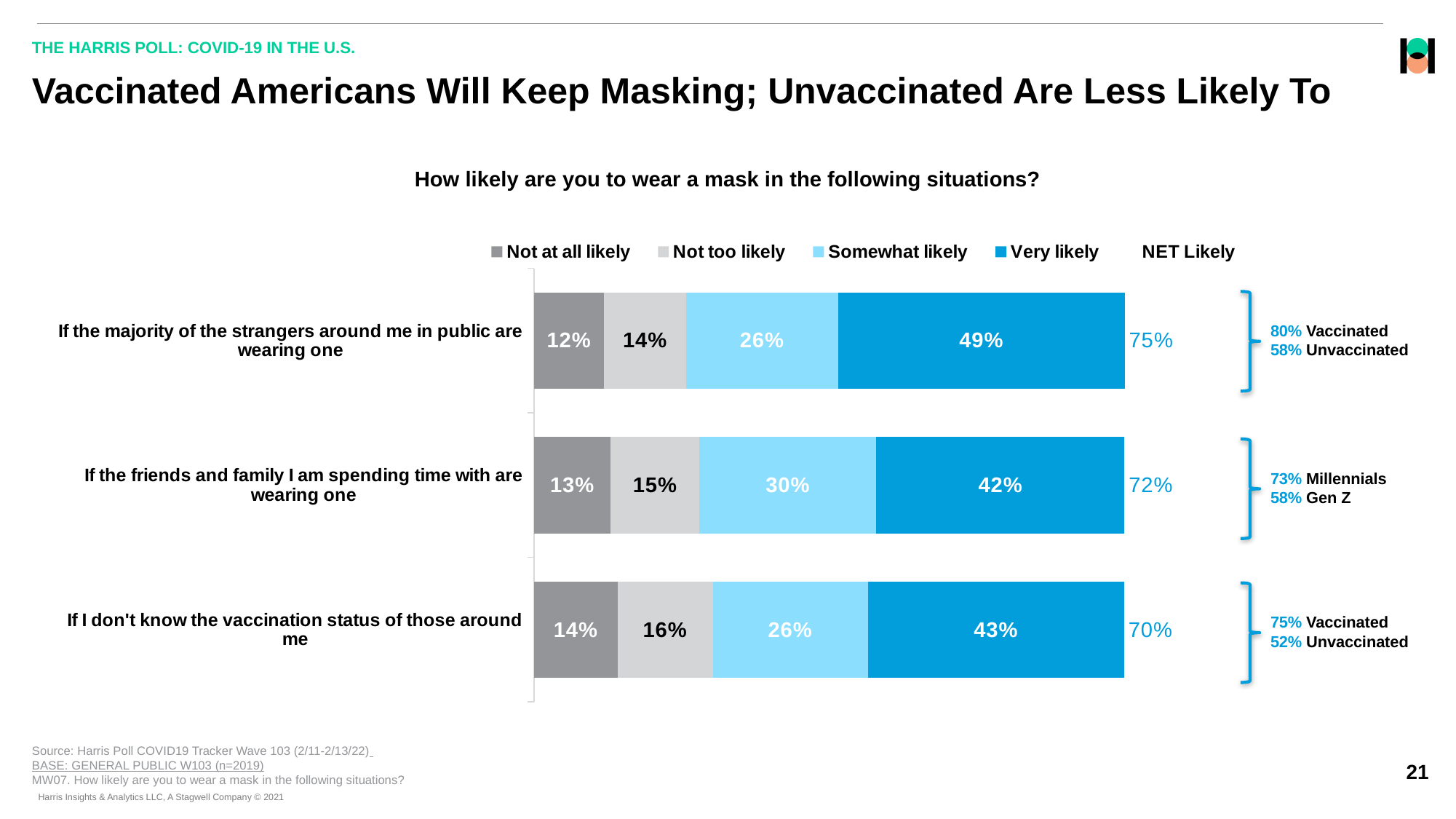
What is the difference between the "Very likely" values for the strangers-in-public situation and the friends-and-family situation? 7% Which situation has the highest "Very likely" percentage? If the majority of the strangers around me in public are wearing one What is the "Somewhat likely" value for "If the friends and family I am spending time with are wearing one"? 30% What percentage of respondents are "Very likely" to wear a mask if the majority of strangers around them in public are wearing one? 49% Which situation has the lowest NET Likely value? If I don't know the vaccination status of those around me Is the "Not too likely" value larger for the friends-and-family situation or for the unknown-vaccination-status situation? If I don't know the vaccination status of those around me How many response categories does the legend list for the stacked bars? 4 What type of chart is shown on the slide? Stacked bar chart What is the NET Likely value for "If the majority of the strangers around me in public are wearing one"? 75% What is the "Not at all likely" value for "If I don't know the vaccination status of those around me"? 14% How many situations (categories) are shown in the chart? 3 What is the total of the "Somewhat likely" and "Very likely" segments for "If I don't know the vaccination status of those around me"? 69%